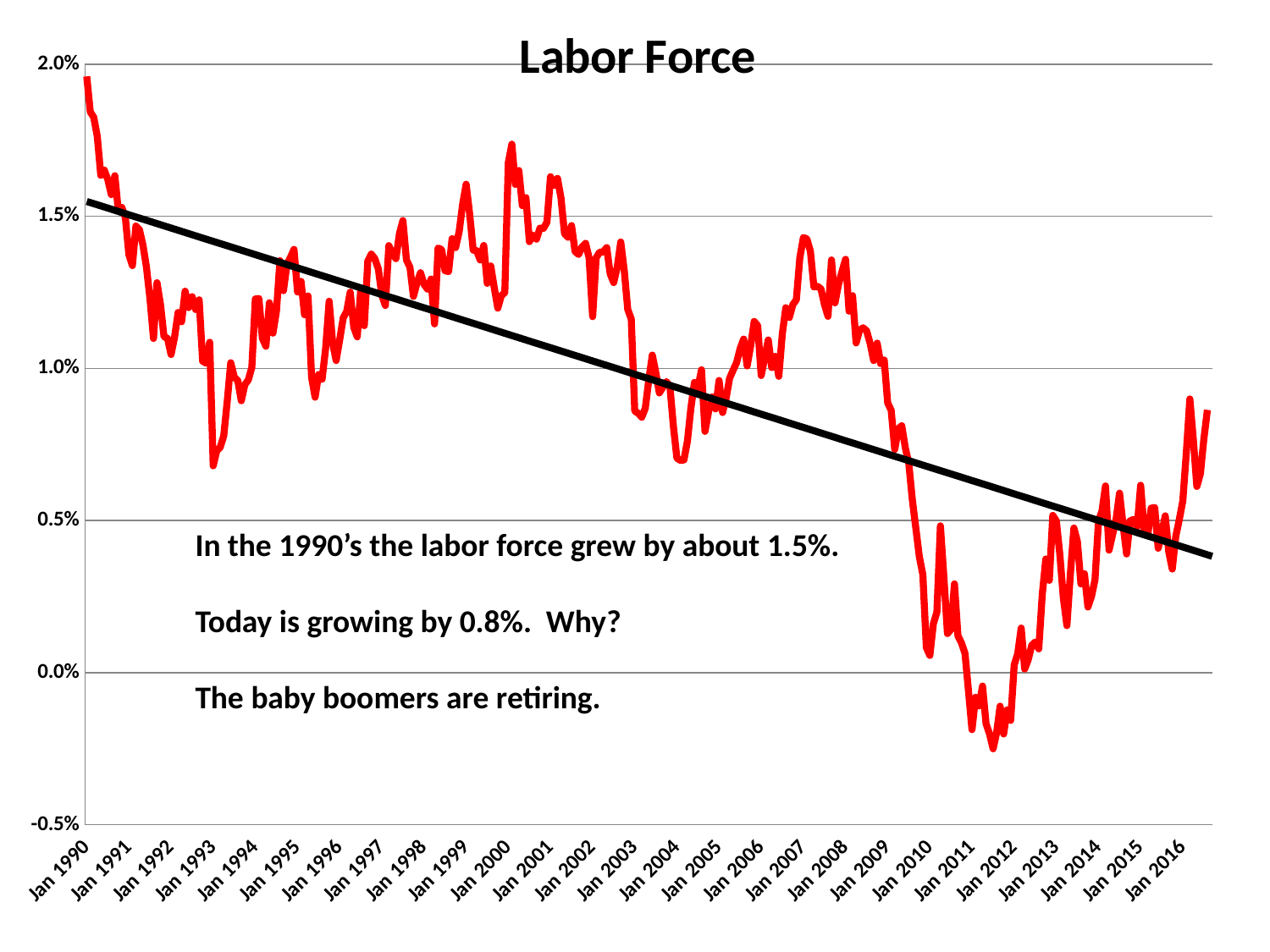
Is the value for Jan 2013 greater or less than 1.0%? less What is the title of the chart? Labor Force Which is larger, the value for Jan 1990 or the value for Jan 2011? Jan 1990 Is the value for Jan 2011 greater or less than 0.0%? less Is the value for Jan 2007 greater or less than 1.0%? greater How many year labels are shown on the x axis? 27 What colour is the straight trend line on the chart? black What kind of chart is shown on the slide? line chart Does the black trend line rise or fall from Jan 1990 to Jan 2016? fall